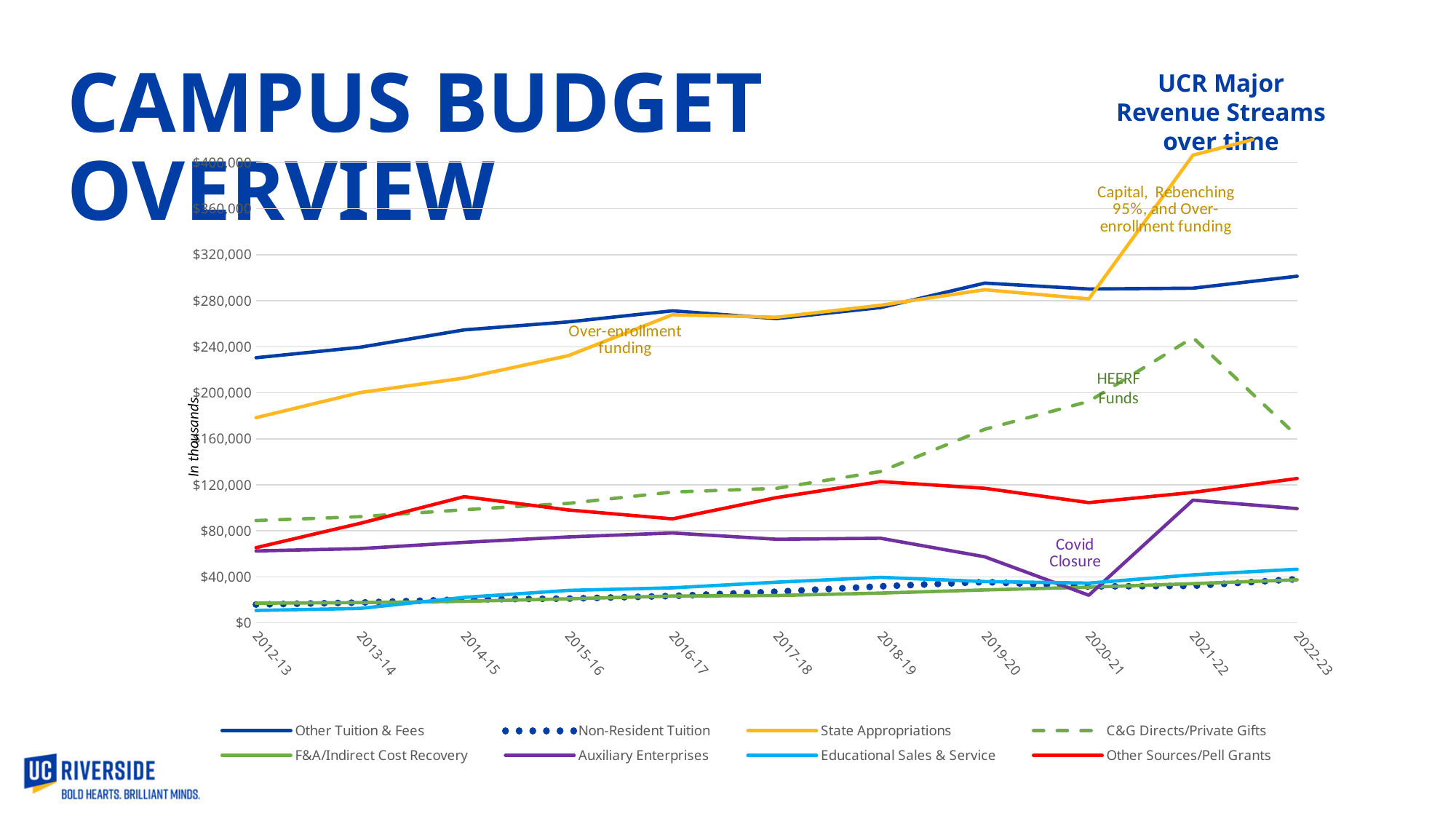
How many fiscal years are shown along the x axis of the chart? 11 Which series is drawn as a dotted line in the chart? Non-Resident Tuition In 2021-22, which is higher: State Appropriations or Other Tuition & Fees? State Appropriations Which series has the highest value in 2022-23? State Appropriations Is the value for State Appropriations in 2022-23 greater or less than $400,000? greater What is the title of the chart? UCR Major Revenue Streams over time In 2014-15, which is higher: Other Sources/Pell Grants or Auxiliary Enterprises? Other Sources/Pell Grants Is the value for Other Tuition & Fees in 2012-13 greater or less than $200,000? greater In which year does C&G Directs/Private Gifts reach its peak? 2021-22 What kind of chart is shown on the slide? Line chart Does Other Tuition & Fees generally rise or fall from 2012-13 to 2022-23? Rise How many series does the legend of the chart list? 8